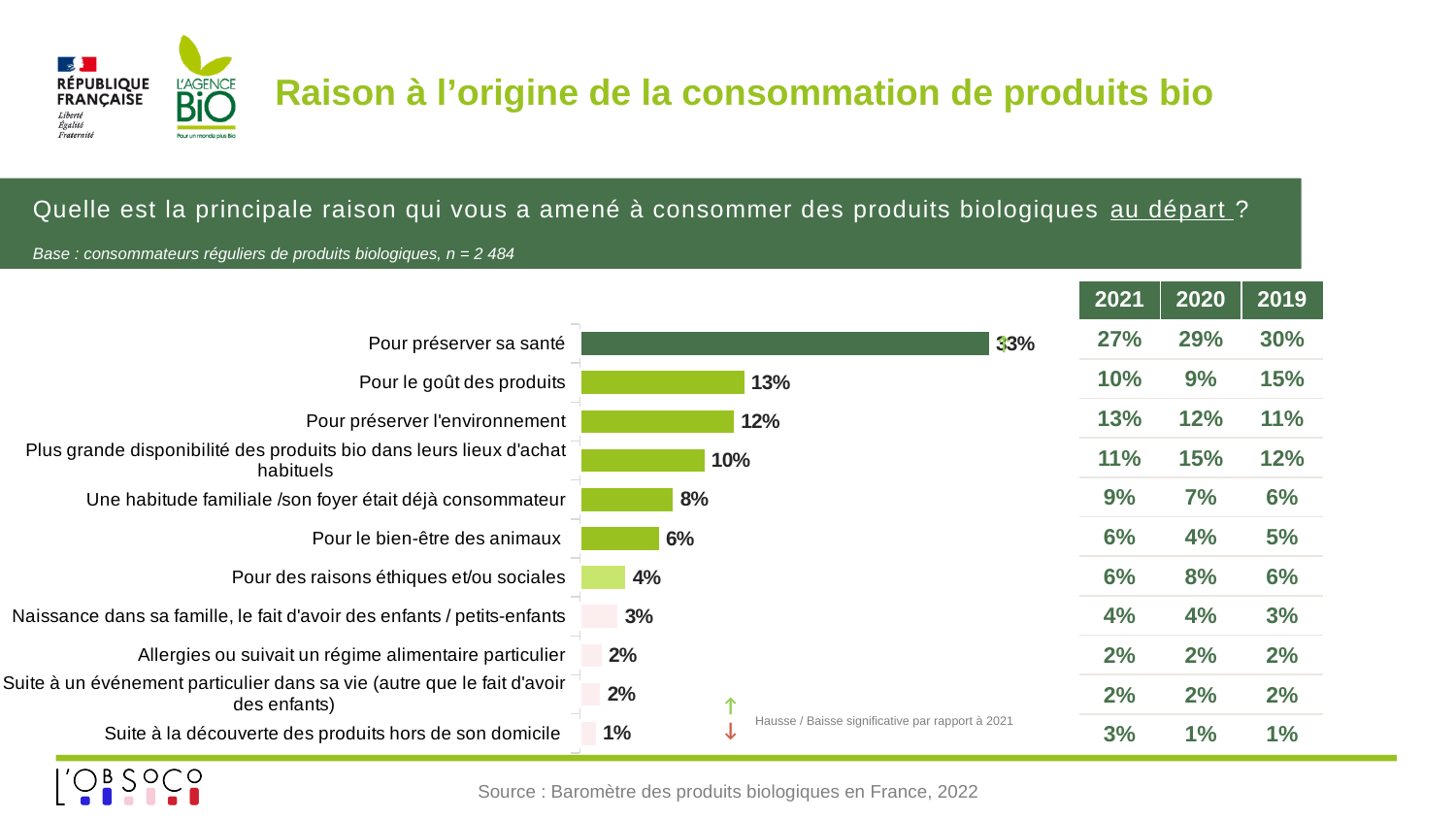
Which is larger, the value for "Pour des raisons éthiques et/ou sociales" or the value for "Plus grande disponibilité des produits bio dans leurs lieux d'achat habituels"? Plus grande disponibilité des produits bio dans leurs lieux d'achat habituels Which years are listed as column headers in the table to the right of the chart? 2021, 2020, 2019 What is the value for "Pour préserver l'environnement"? 12% What is the value for "Une habitude familiale /son foyer était déjà consommateur"? 8% What is the value for "Pour le goût des produits"? 13% How many categories are shown in the bar chart? 11 Which category has the lowest value? Suite à la découverte des produits hors de son domicile What is the difference between the values for "Pour préserver sa santé" and "Pour le goût des produits"? 20% What kind of chart is shown on the slide? Bar chart What is the difference between the values for "Pour préserver l'environnement" and "Pour le bien-être des animaux"? 6% What is the value for "Pour le bien-être des animaux"? 6% Which category has the highest value? Pour préserver sa santé